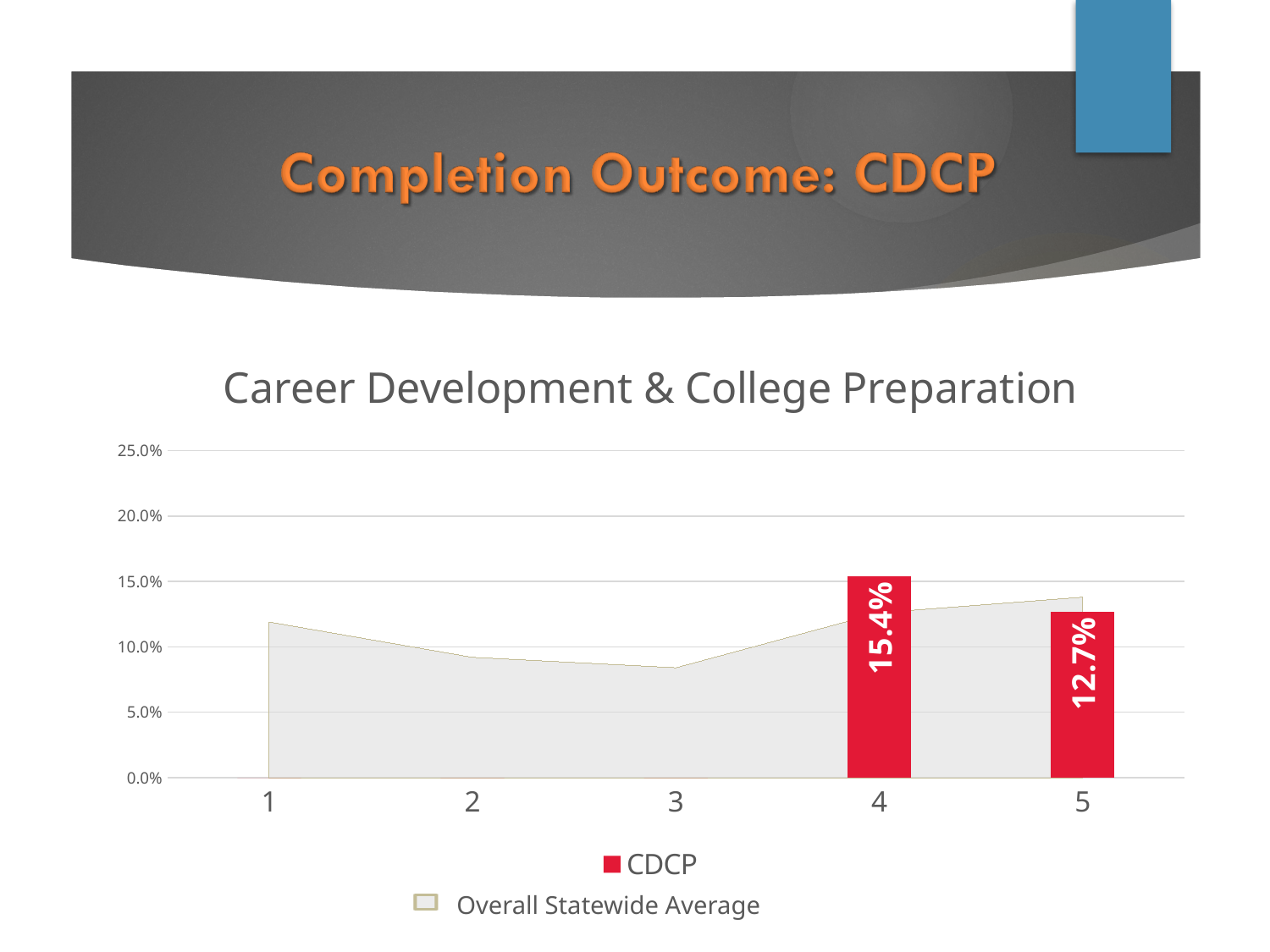
At which category is the Overall Statewide Average lowest? 3 How many series does the legend list? 2 Is the Overall Statewide Average at category 1 greater or less than 10.0%? greater What colour are the CDCP bars? Red What is the difference between the CDCP values at categories 4 and 5? 2.7% Which category has the higher CDCP value, 4 or 5? 4 What is the CDCP value at category 5? 12.7% What is the CDCP value at category 4? 15.4% How many categories are shown on the x axis? 5 Does the Overall Statewide Average rise or fall from category 1 to category 3? fall Is the Overall Statewide Average at category 3 greater or less than 10.0%? less What is the title of the chart? Career Development & College Preparation